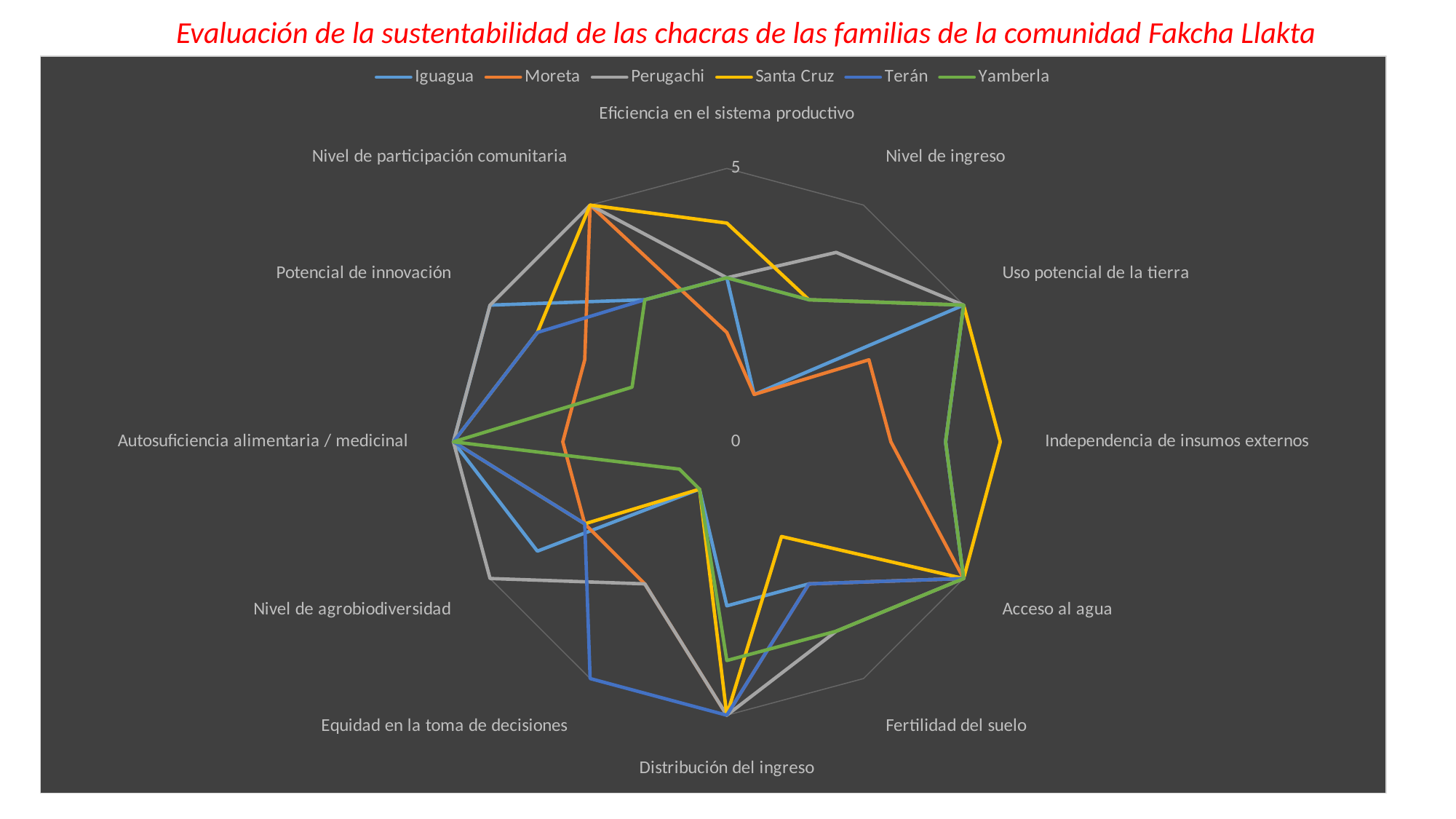
Which series has the highest value for Independencia de insumos externos? Santa Cruz Which series has the highest value for Equidad en la toma de decisiones? Terán For Independencia de insumos externos, which is larger: Santa Cruz or Moreta? Santa Cruz What is the title of the chart? Evaluación de la sustentabilidad de las chacras de las familias de la comunidad Fakcha Llakta Is the value of Moreta for Independencia de insumos externos greater or less than 5? less How many categories (axes) does the radar chart have? 12 Is the value of Santa Cruz for Equidad en la toma de decisiones greater or less than 5? less How many series does the legend list? 6 For Nivel de ingreso, which is larger: Perugachi or Iguagua? Perugachi What is the maximum value shown on the chart's axis scale? 5 What kind of chart is shown on the slide? Radar chart Which series has the highest value for Nivel de agrobiodiversidad? Perugachi